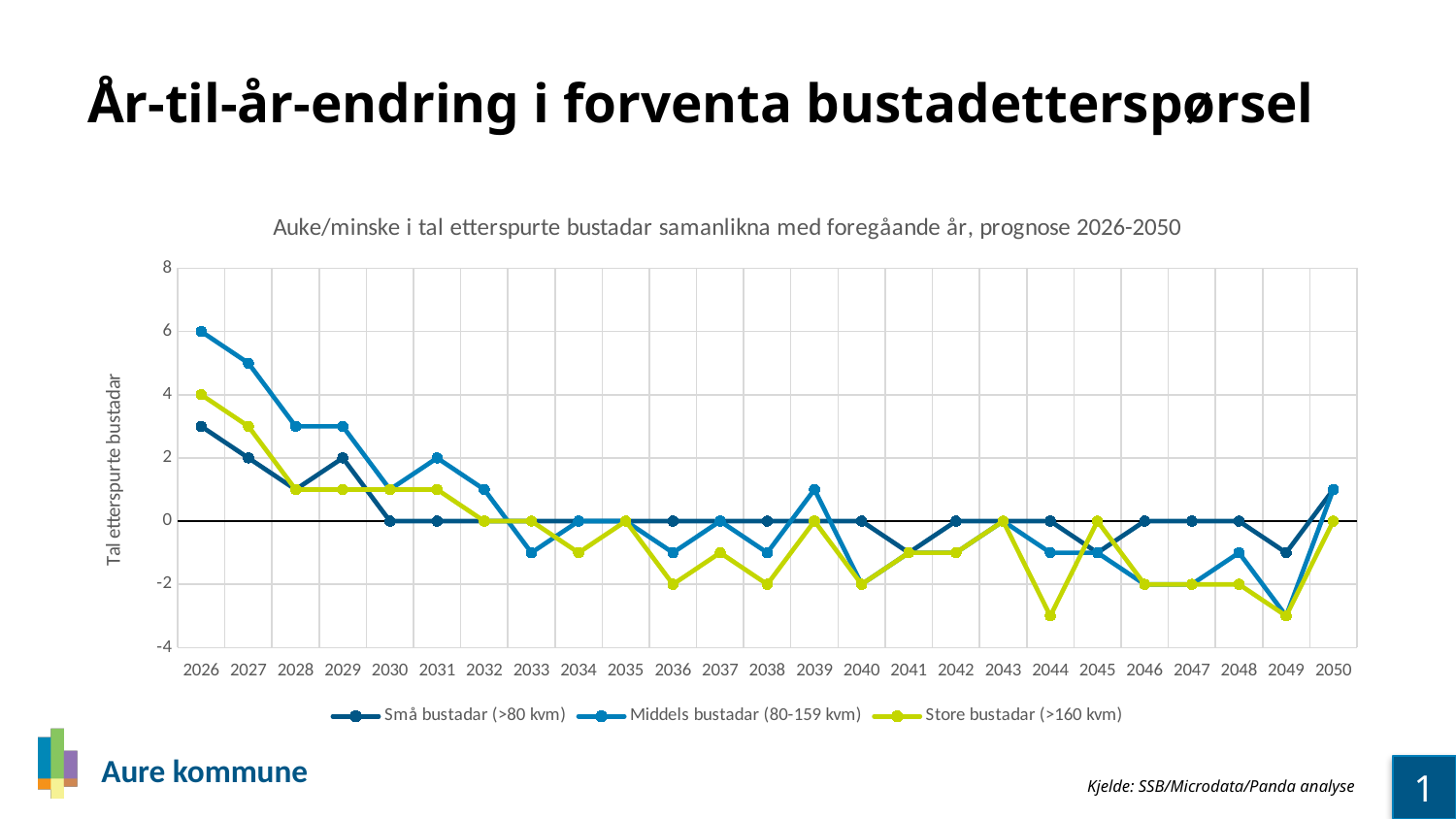
What is the value for Middels bustadar (80-159 kvm) in 2026? 6 How many years are plotted along the x axis? 25 Does the Middels bustadar (80-159 kvm) line rise or fall from 2026 to 2030? fall What is the value for Store bustadar (>160 kvm) in 2036? -2 What kind of chart is shown on the slide? line chart How many series does the legend list? 3 What is the value for Store bustadar (>160 kvm) in 2026? 4 Is the value for Middels bustadar (80-159 kvm) in 2049 greater or less than -2? less What is the difference between Middels bustadar (80-159 kvm) and Store bustadar (>160 kvm) in 2026? 2 Which series has the highest value in 2026? Middels bustadar (80-159 kvm) Is the value for Små bustadar (>80 kvm) in 2026 greater or less than 2? greater What is the value for Middels bustadar (80-159 kvm) in 2031? 2